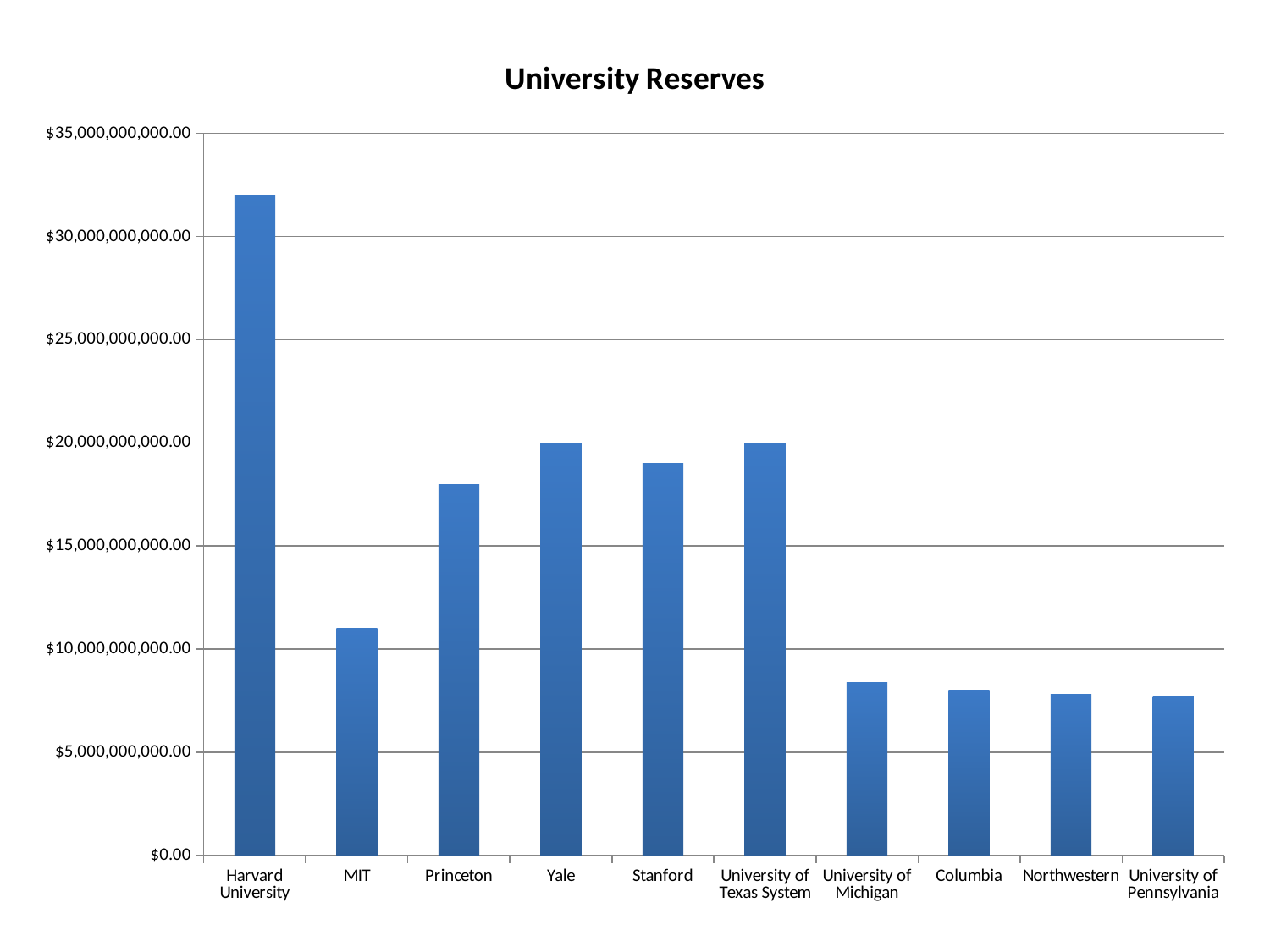
Is the value for University of Michigan greater or less than $10,000,000,000.00? less What colour are the bars in the chart? blue Is the value for Harvard University greater or less than $30,000,000,000.00? greater What is the title of the chart? University Reserves Is the value for Columbia greater or less than $5,000,000,000.00? greater How many universities are shown on the x axis of the chart? 10 Which has larger reserves, MIT or Princeton? Princeton Which has larger reserves, Stanford or Columbia? Stanford What kind of chart is shown on the slide? bar chart Which university has the highest reserves in the chart? Harvard University